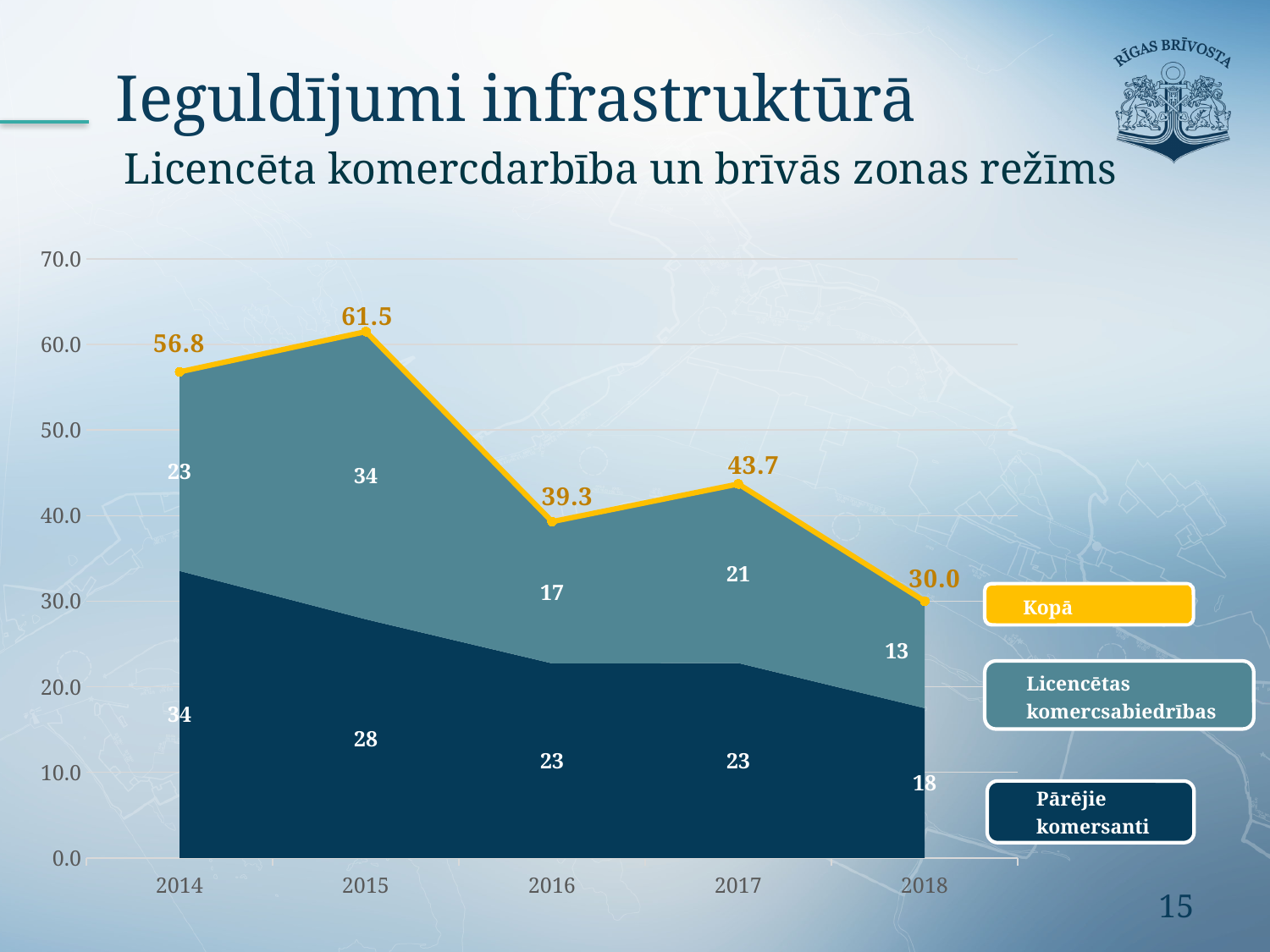
What is the value for Licencētas komercsabiedrības in 2016? 17 How many years are shown on the x axis? 5 What is the value for Pārējie komersanti in 2014? 34 Is the Kopā value for 2016 greater or less than 40.0? less What is the difference between the Kopā values for 2014 and 2018? 26.8 Does the Pārējie komersanti value rise or fall from 2014 to 2018? fall How many series does the legend list? 3 Which is larger in 2017: Pārējie komersanti or Licencētas komercsabiedrības? Pārējie komersanti In which year is the Kopā value highest? 2015 What is the Kopā value for 2015? 61.5 What kind of chart is shown on the slide? Stacked area chart with a line for the total In which year is the Kopā value lowest? 2018